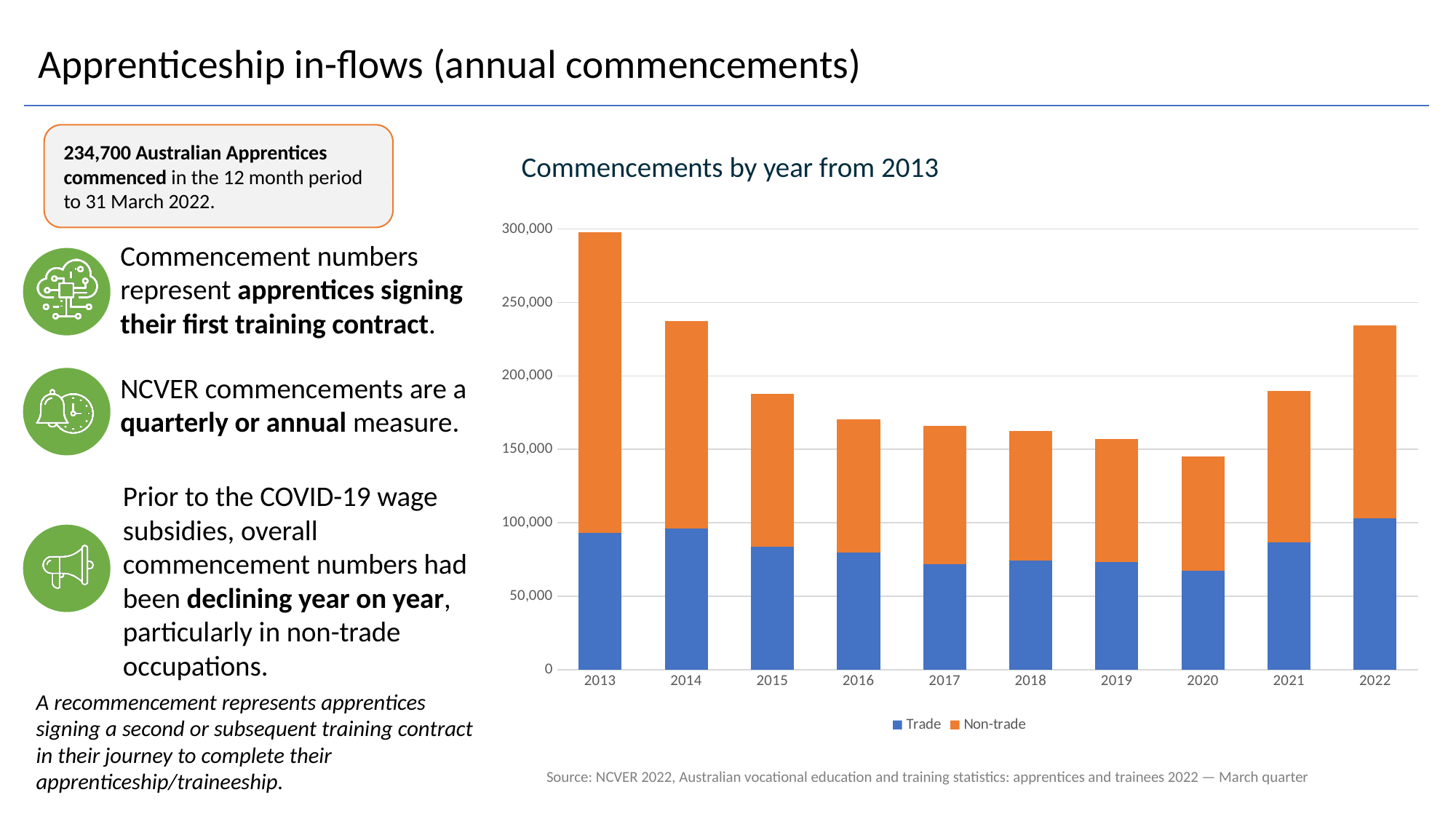
What kind of chart is shown on the slide? Stacked bar chart Is the total commencements value for 2021 greater or less than 200,000? less How many series does the chart's legend list? 2 Which year has the larger total commencements, 2021 or 2022? 2022 Do total commencements rise or fall from 2013 to 2020? fall Which year has the lowest total commencements in the chart? 2020 Is the Trade value for 2015 greater or less than 100,000? less Which year has the highest total commencements in the chart? 2013 How many years are shown on the x axis of the chart? 10 Is the total commencements value for 2013 greater or less than 250,000? greater What is the title of the chart? Commencements by year from 2013